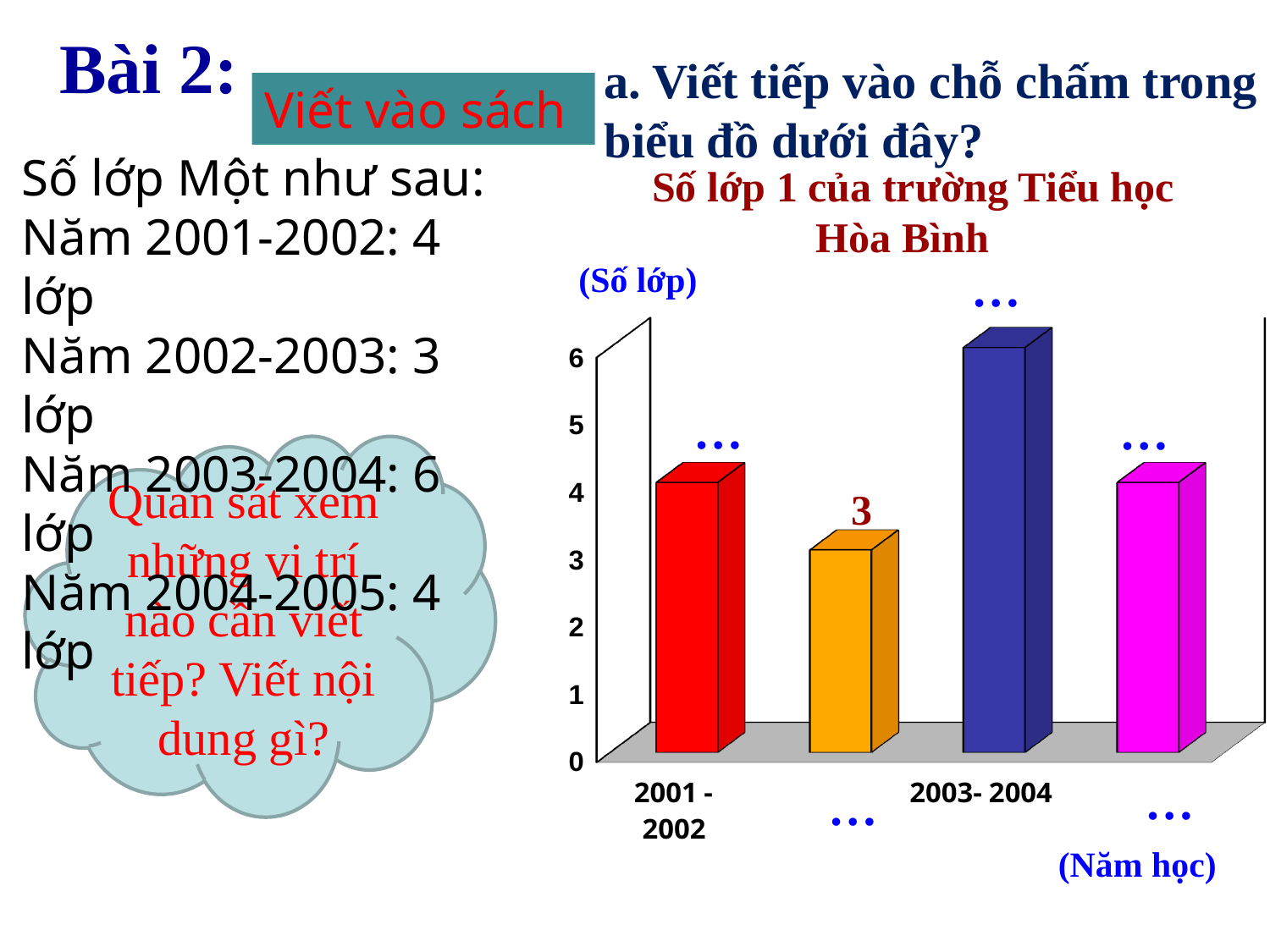
Is the value for 2001 - 2002 greater or less than 5? less What is the only data value printed above a bar on the chart? 3 How many bars does the chart show? 4 What kind of chart is shown on the slide? bar chart Which is larger, the bar for 2001 - 2002 or the orange bar labelled 3? 2001 - 2002 Is the value for 2001 - 2002 greater or less than 3? greater Is the value for 2003- 2004 greater or less than 5? greater What label is written on the vertical axis of the chart? (Số lớp) What value is printed above the orange bar? 3 Which is larger, the bar for 2001 - 2002 or the bar for 2003- 2004? 2003- 2004 What is the title of the chart? Số lớp 1 của trường Tiểu học Hòa Bình Which school year has the tallest bar on the chart? 2003- 2004